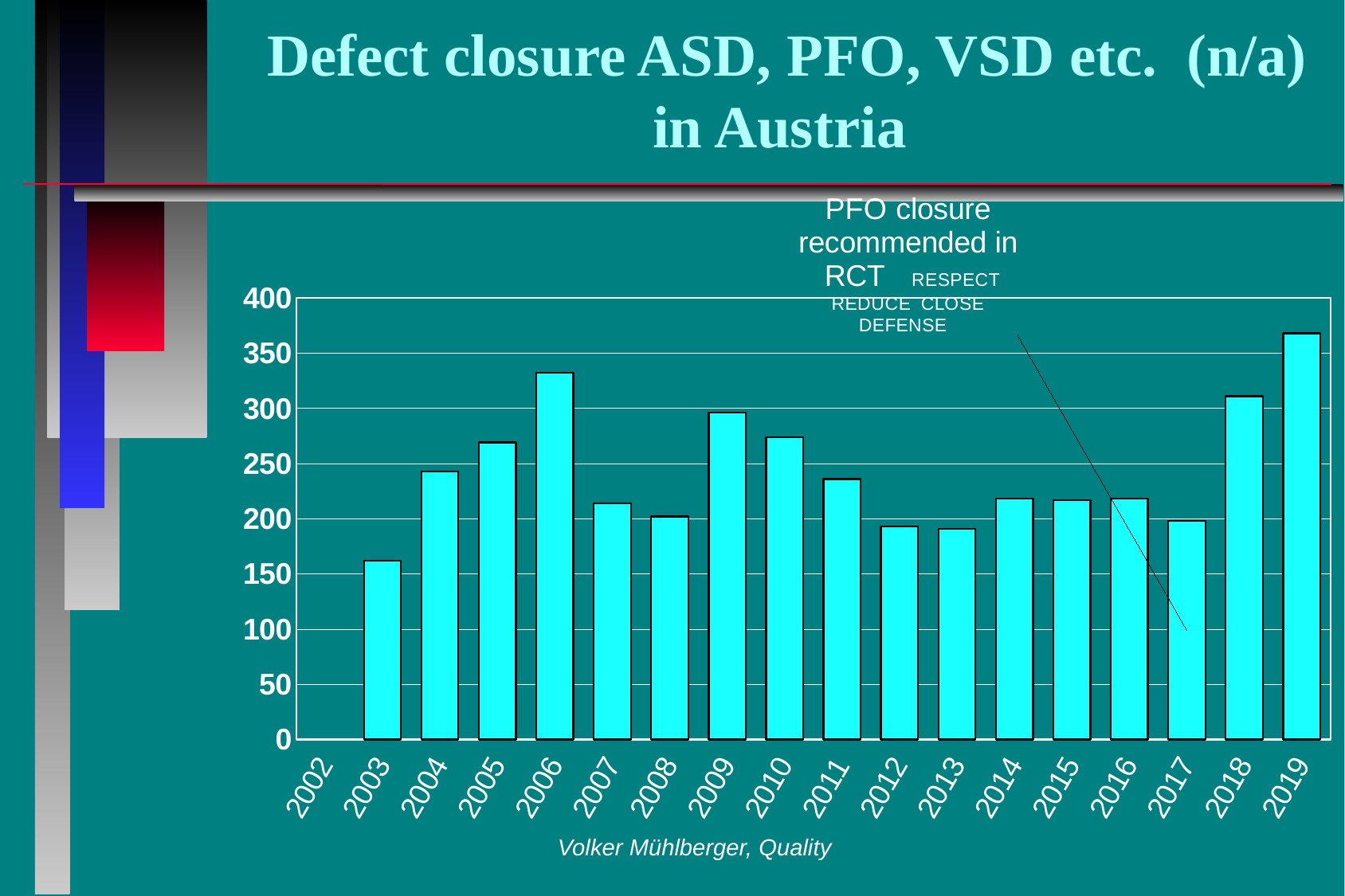
Is the value for 2006 greater or less than 300? greater Which year has the larger value, 2003 or 2004? 2004 Which year has the larger value, 2006 or 2009? 2006 What kind of chart is shown on the slide? bar chart Which year with a bar has the lowest value in the chart? 2003 How many years are labeled on the x axis? 18 Is the value for 2005 greater or less than 250? greater Is the value for 2011 greater or less than 250? less Do the values rise or fall from 2017 to 2019? rise Which year has the highest value in the chart? 2019